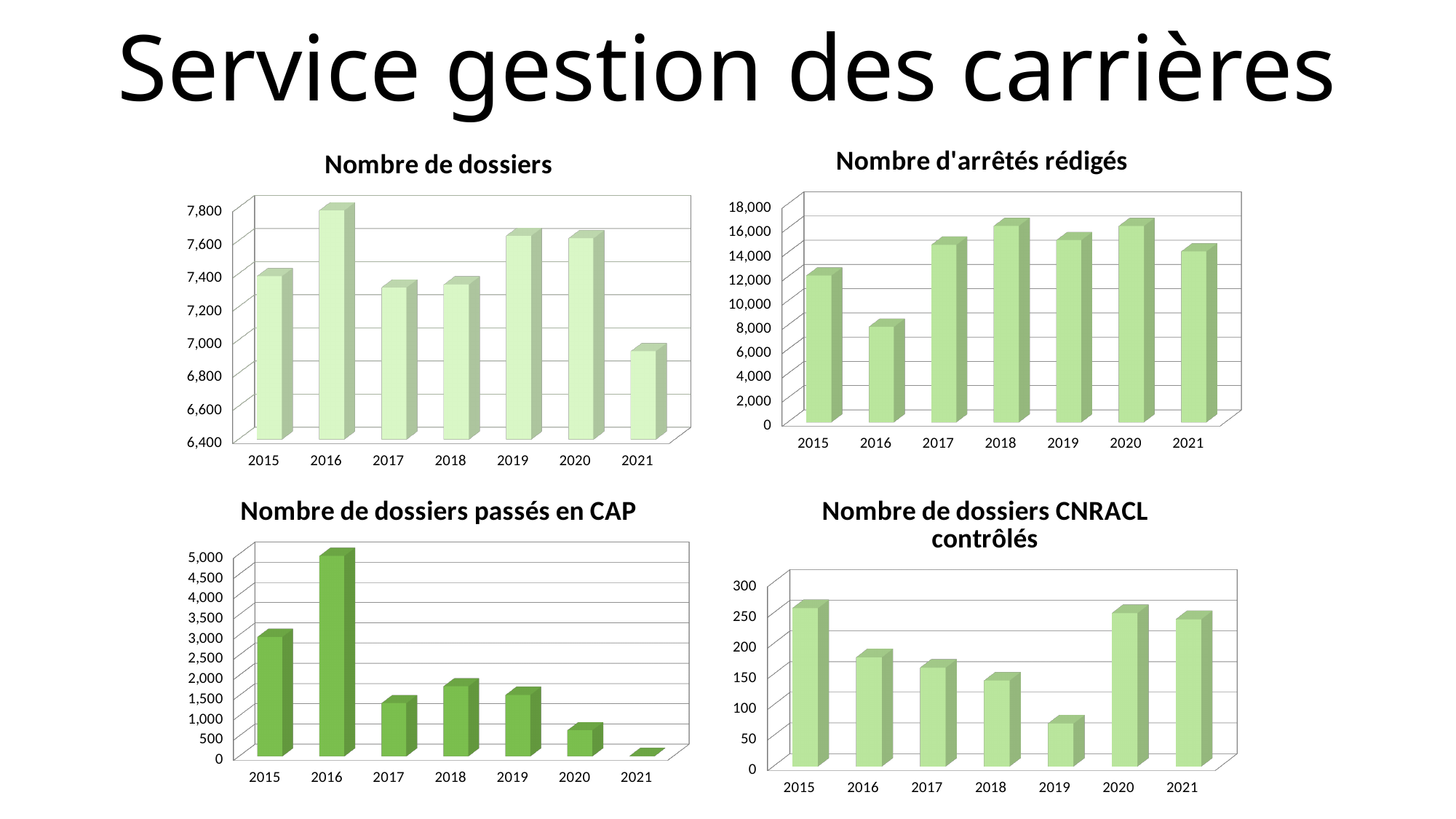
In the 'Nombre d'arrêtés rédigés' chart, which is larger, the value for 2015 or the value for 2017? 2017 In the 'Nombre de dossiers' chart, which year has the highest value? 2016 In the 'Nombre de dossiers passés en CAP' chart, is the value for 2015 greater or less than 2,500? greater In the 'Nombre de dossiers' chart, is the value for 2021 greater or less than 7,000? less How many years are shown on the x axis of the 'Nombre de dossiers CNRACL contrôlés' chart? 7 In the 'Nombre de dossiers passés en CAP' chart, which year has the highest value? 2016 In the 'Nombre d'arrêtés rédigés' chart, which year has the lowest value? 2016 In the 'Nombre de dossiers CNRACL contrôlés' chart, is the value for 2019 greater or less than 100? less In the 'Nombre de dossiers' chart, which year has the lowest value? 2021 In the 'Nombre de dossiers passés en CAP' chart, which year has the lowest value? 2021